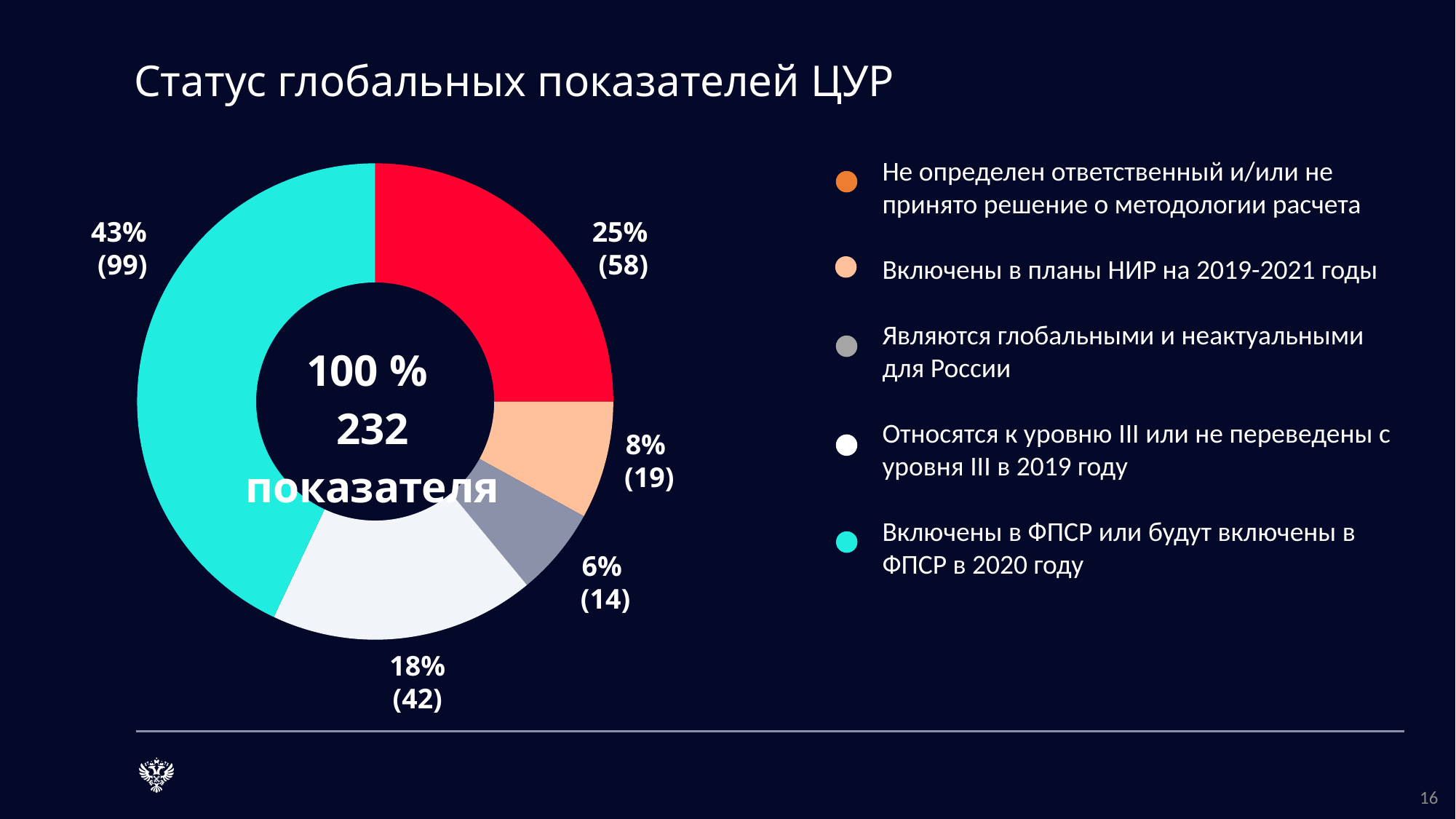
How many indicators are in the category 'Являются глобальными и неактуальными для России'? 14 What share of the chart is taken by the category 'Относятся к уровню III или не переведены с уровня III в 2019 году'? 18% How many categories does the legend of the chart list? 5 What share of the chart is taken by the category 'Включены в ФПСР или будут включены в ФПСР в 2020 году'? 43% What is the difference in the number of indicators between the 43% slice and the 18% slice? 57 What share of the chart is taken by the category 'Включены в планы НИР на 2019-2021 годы'? 8% Which category has the largest share of the chart? Включены в ФПСР или будут включены в ФПСР в 2020 году How many indicators fall into the category 'Включены в ФПСР или будут включены в ФПСР в 2020 году'? 99 What total number of indicators is shown in the centre of the chart? 232 What kind of chart is shown on the slide? Pie (donut) chart Which category has the smallest share of the chart? Являются глобальными и неактуальными для России Which is larger: the share of 'Включены в планы НИР на 2019-2021 годы' or the share of 'Являются глобальными и неактуальными для России'? Включены в планы НИР на 2019-2021 годы